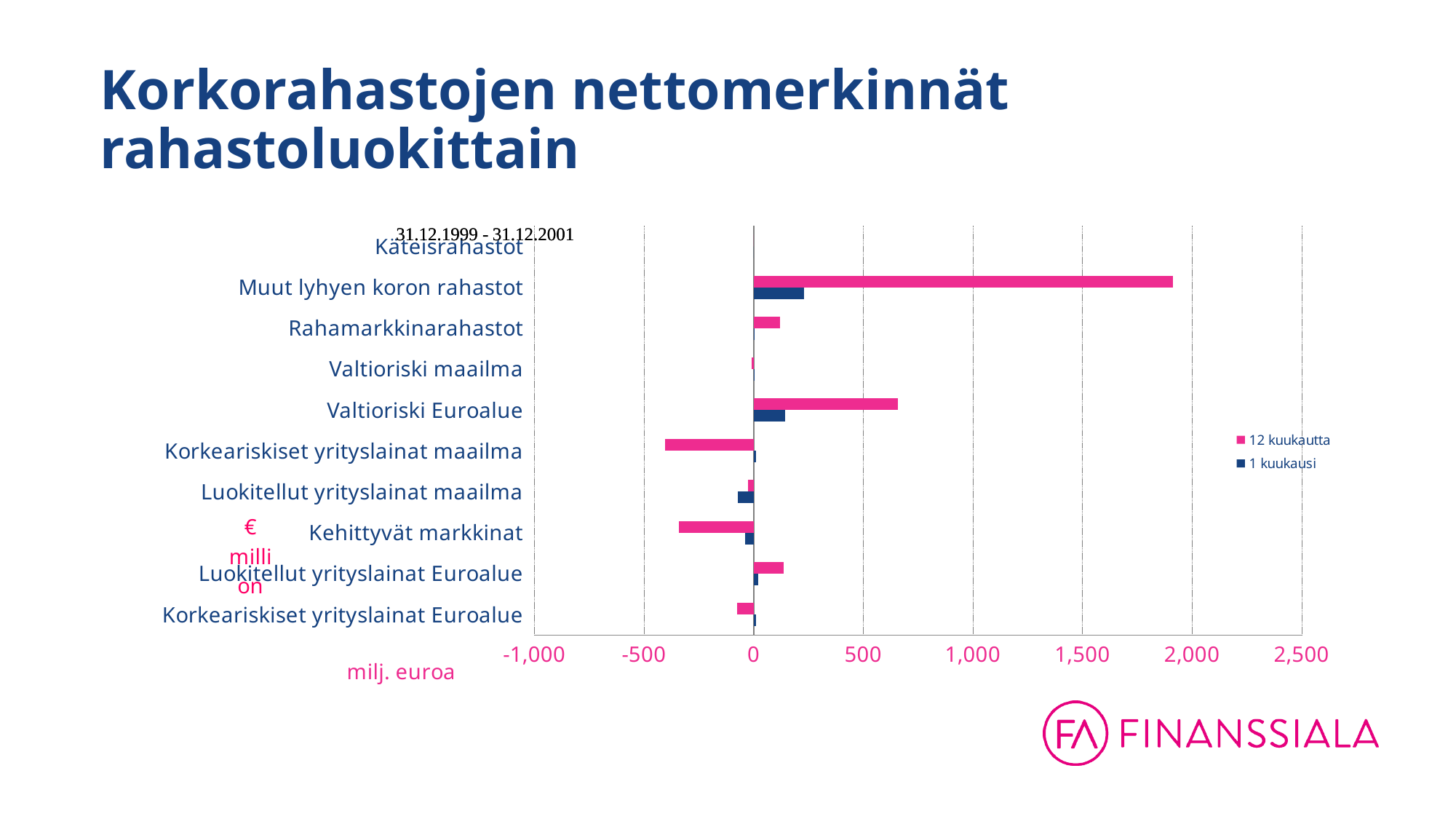
What are the two series named in the legend? 12 kuukautta and 1 kuukausi Is the 12 kuukautta value for Valtioriski Euroalue greater or less than 500? greater Is the 12 kuukautta value for Kehittyvät markkinat greater or less than -500? greater Is the 12 kuukautta value for Muut lyhyen koron rahastot greater or less than 1,500? greater Which is larger for the 1 kuukausi series: Muut lyhyen koron rahastot or Luokitellut yrityslainat maailma? Muut lyhyen koron rahastot How many series does the legend list? 2 How many fund categories are shown on the chart? 10 Which is larger for the 12 kuukautta series: Muut lyhyen koron rahastot or Valtioriski Euroalue? Muut lyhyen koron rahastot Which category has the highest value for the 12 kuukautta series? Muut lyhyen koron rahastot What unit is shown on the x axis of the chart? milj. euroa What kind of chart is shown on the slide? bar chart